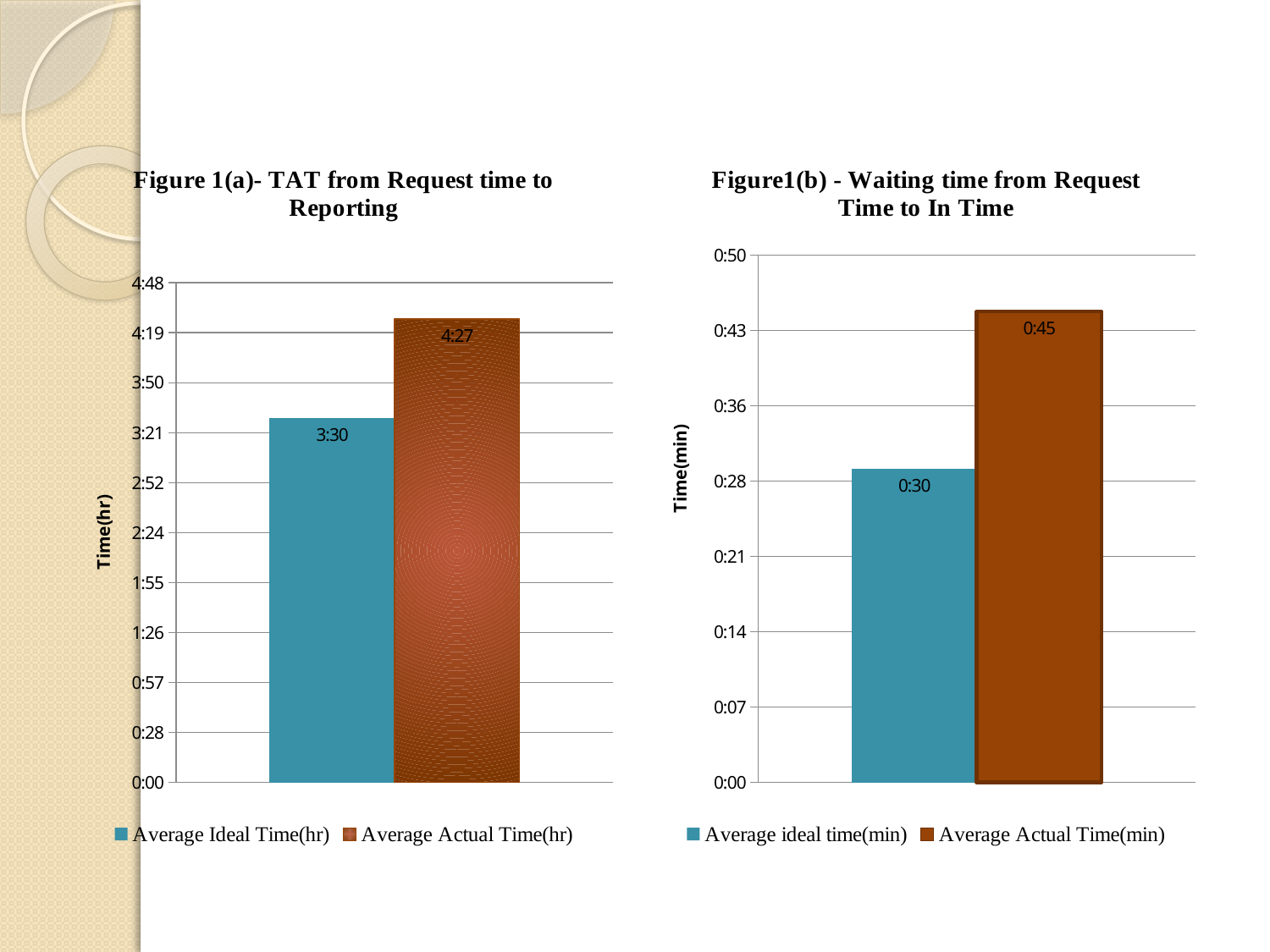
In the Figure 1(a) chart, which series has the higher value, Average Ideal Time(hr) or Average Actual Time(hr)? Average Actual Time(hr) How many series does the legend of the Figure 1(b) chart list? 2 In the Figure 1(a) chart, what is the difference between the Average Actual Time(hr) and the Average Ideal Time(hr)? 0:57 In the Figure 1(a) chart (TAT from Request time to Reporting), what is the Average Ideal Time(hr)? 3:30 What kind of chart is the Figure 1(a) chart? Bar chart In the Figure 1(b) chart (Waiting time from Request Time to In Time), what is the Average ideal time(min)? 0:30 In the Figure 1(b) chart (Waiting time from Request Time to In Time), what is the Average Actual Time(min)? 0:45 In the Figure 1(b) chart, what is the difference between the Average Actual Time(min) and the Average ideal time(min)? 0:15 In the Figure 1(b) chart, which series has the lower value? Average ideal time(min) What is the y-axis label of the Figure 1(b) chart? Time(min) In the Figure 1(a) chart (TAT from Request time to Reporting), what is the Average Actual Time(hr)? 4:27 What is the title of the chart on the left of the slide? Figure 1(a)- TAT from Request time to Reporting